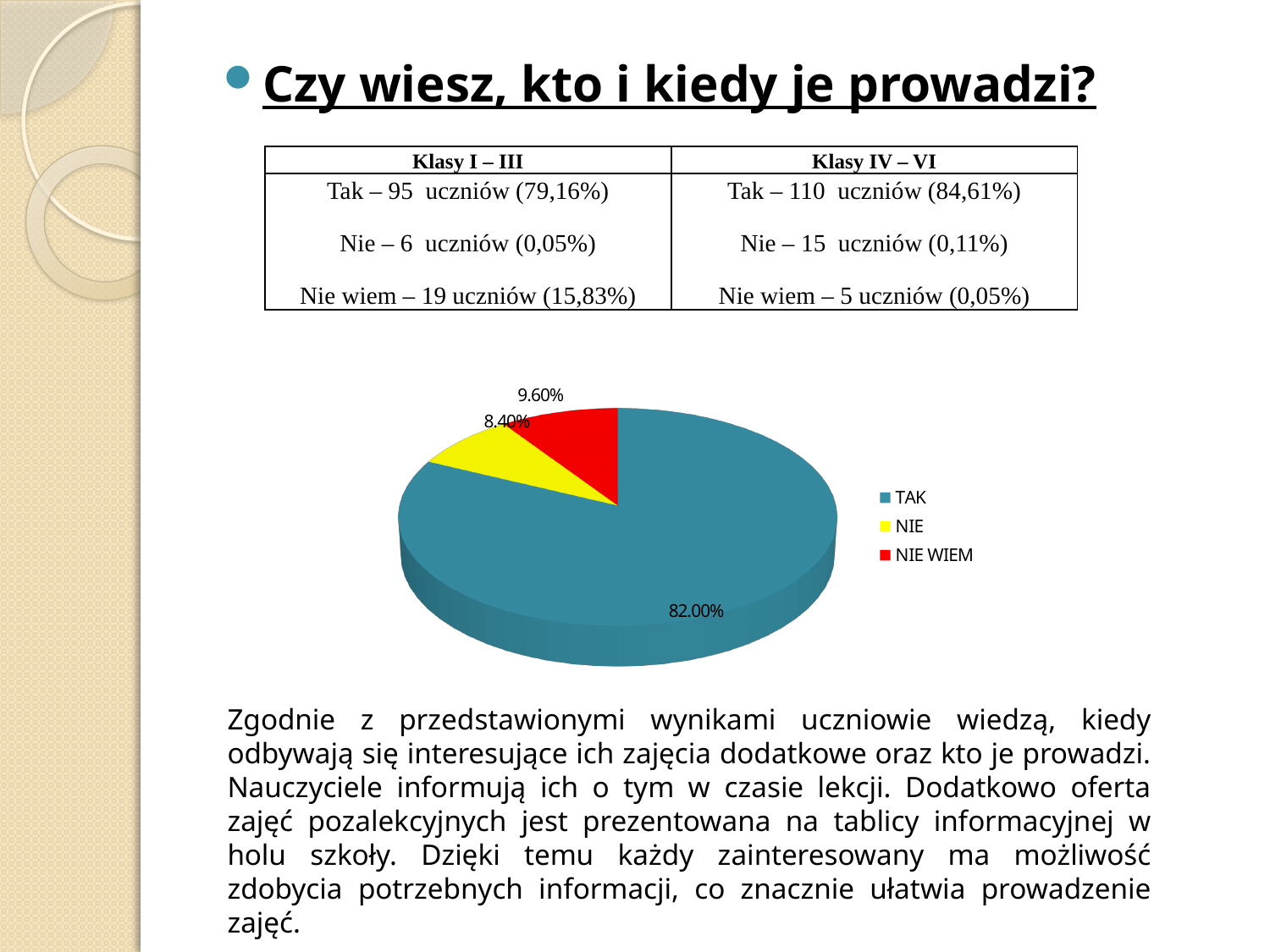
What kind of chart is shown on the slide? pie chart What is the difference between the NIE WIEM and NIE slices in the pie chart? 1.20% Which category has the smallest slice in the pie chart? NIE What percentage does the NIE WIEM slice of the pie chart represent? 9.60% How many entries does the legend of the pie chart list? 3 Which category has the largest slice in the pie chart? TAK What percentage does the NIE slice of the pie chart represent? 8.40% How many slices does the pie chart have? 3 What colour is the NIE WIEM slice in the pie chart? red What is the difference between the TAK and NIE WIEM slices in the pie chart? 72.40% What percentage does the TAK slice of the pie chart represent? 82.00% Which slice is larger in the pie chart, NIE or NIE WIEM? NIE WIEM